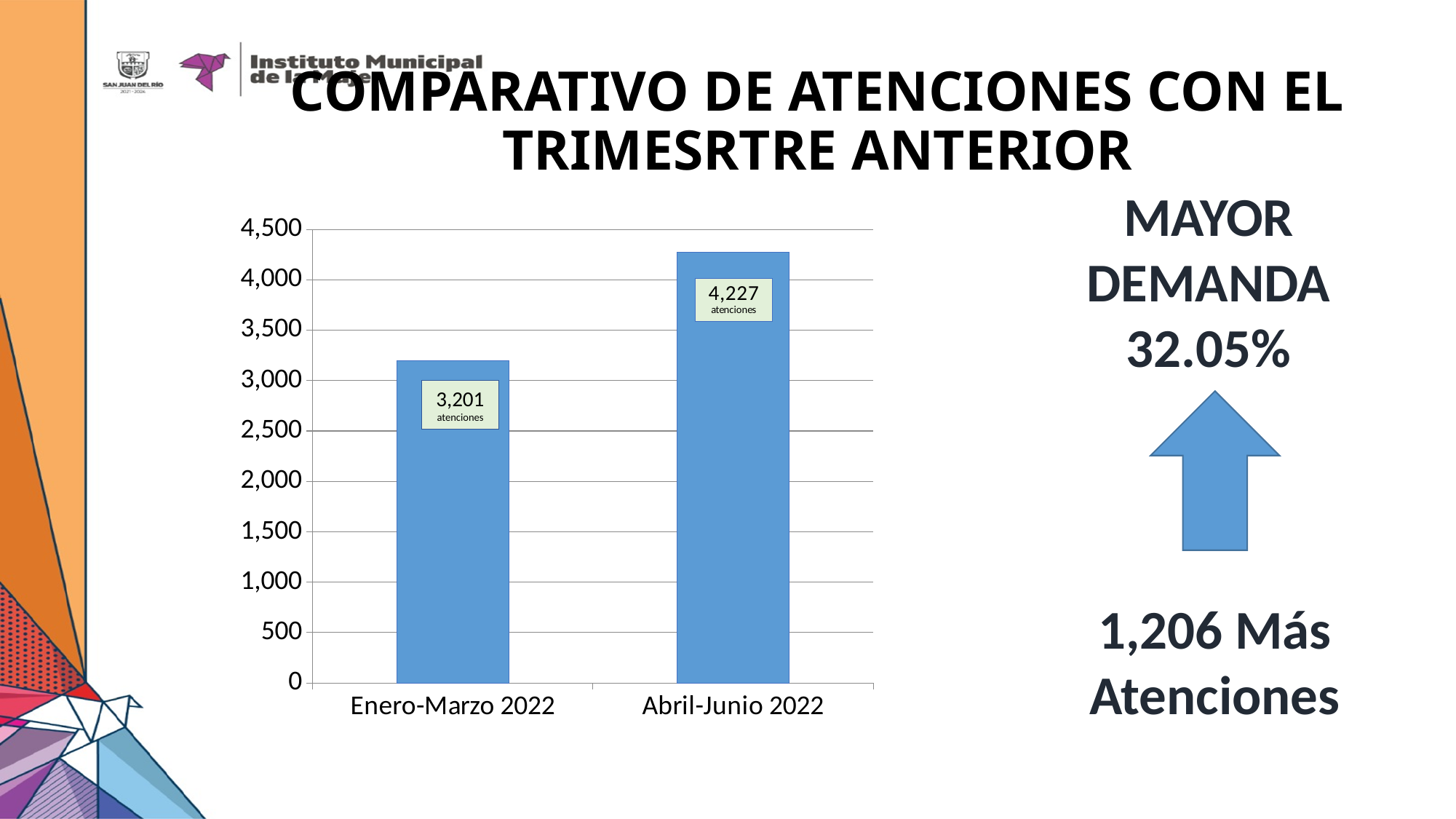
What is the value for Abril-Junio 2022? 4,227 What kind of chart is shown on the slide? bar chart Is the value for Abril-Junio 2022 greater or less than 4,000? greater Which category has the lowest value? Enero-Marzo 2022 Which is larger, the value for Enero-Marzo 2022 or the value for Abril-Junio 2022? Abril-Junio 2022 What is the title of the slide containing the chart? COMPARATIVO DE ATENCIONES CON EL TRIMESRTRE ANTERIOR Do the values rise or fall from Enero-Marzo 2022 to Abril-Junio 2022? rise Is the value for Enero-Marzo 2022 greater or less than 3,500? less Which category has the highest value? Abril-Junio 2022 How many categories are shown on the x axis? 2 What is the value for Enero-Marzo 2022? 3,201